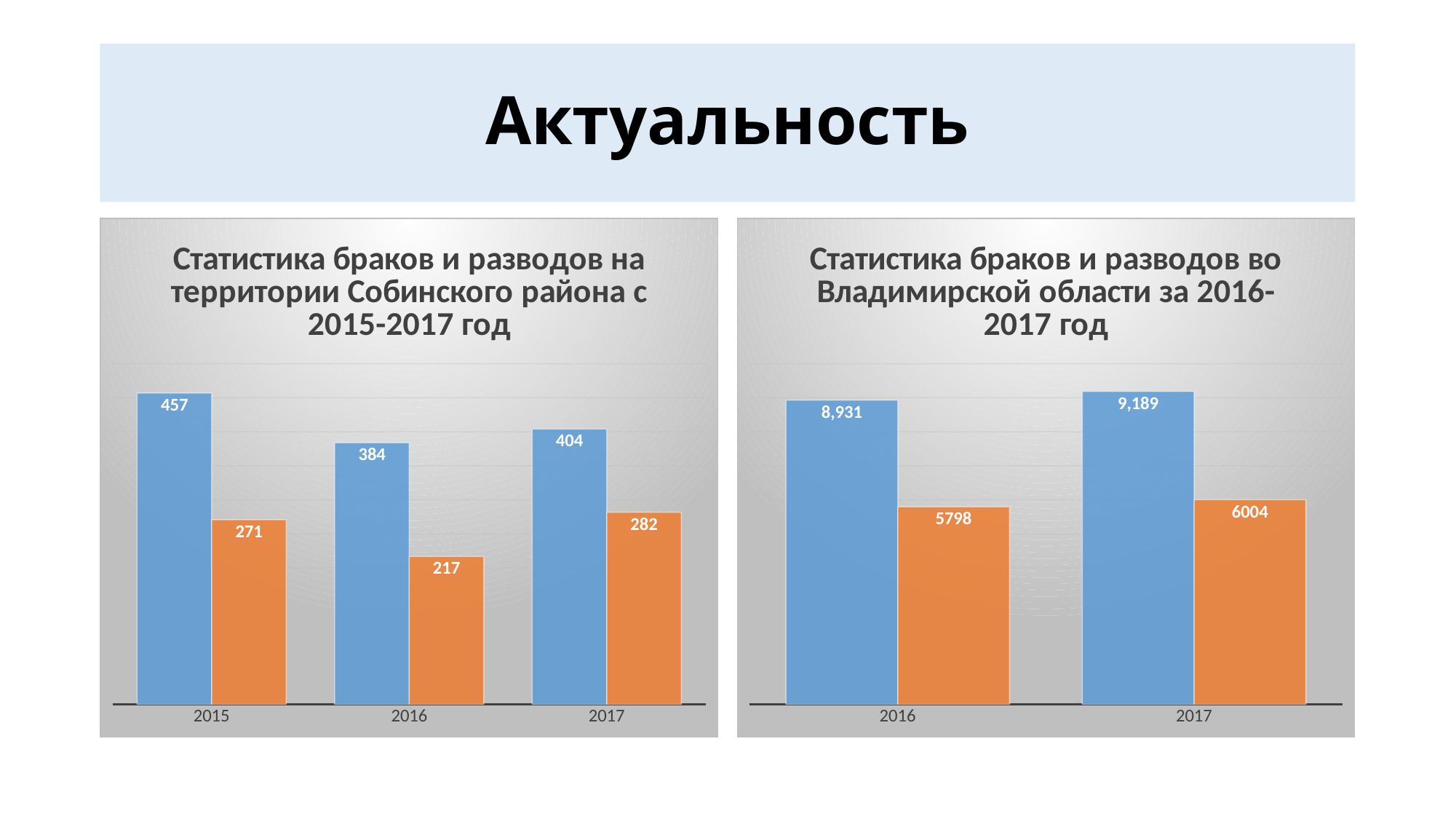
In the right chart (Владимирская область), what is the difference between the orange bars for 2017 and 2016? 206 In the right chart (Владимирская область), what is the value of the orange bar for 2016? 5798 How many years are shown on the x axis of the left chart (Собинский район)? 3 In the left chart (Собинский район), what is the difference between the blue and orange bars for 2017? 122 In the left chart (Собинский район), which year has the highest blue bar? 2015 In the left chart (Собинский район), which is larger: the blue bar for 2016 or the blue bar for 2017? 2017 In the left chart (Собинский район), what is the value of the orange bar for 2016? 217 In the left chart (Собинский район), what is the value of the blue bar for 2015? 457 In the right chart (Владимирская область), what is the value of the blue bar for 2017? 9,189 In the left chart (Собинский район), which year has the lowest orange bar? 2016 What kind of chart is the right chart (Владимирская область)? bar chart In the right chart (Владимирская область), do the blue bars rise or fall from 2016 to 2017? rise